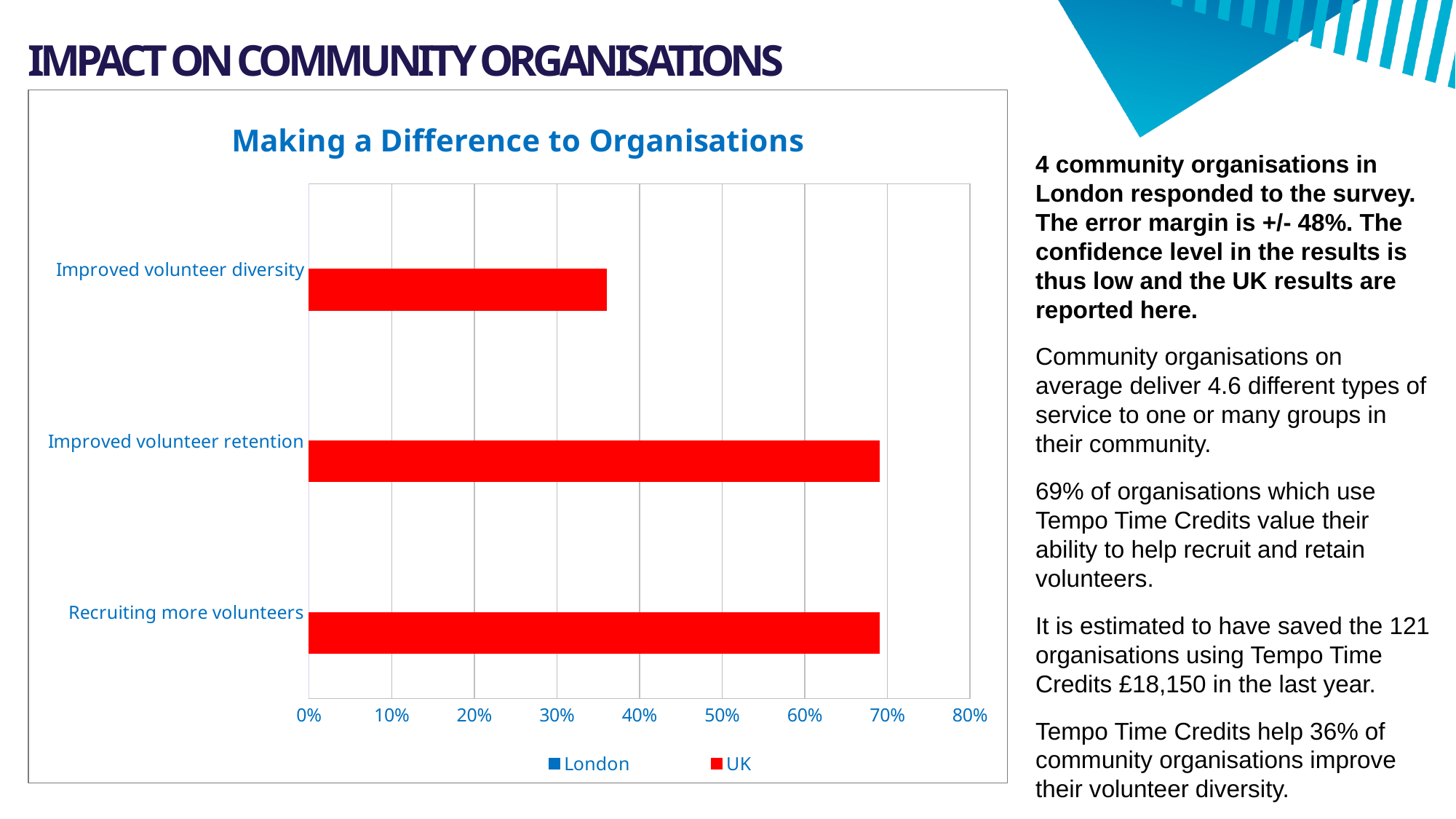
Which category has the lowest UK value? Improved volunteer diversity Which has a larger UK value: Improved volunteer retention or Improved volunteer diversity? Improved volunteer retention Is the UK value for Improved volunteer diversity greater or less than 30%? greater Is the UK value for Recruiting more volunteers greater or less than 60%? greater Is the UK value for Improved volunteer diversity greater or less than 40%? less What kind of chart is shown on the slide? bar chart How many series does the chart legend list? 2 What is the title of the chart? Making a Difference to Organisations What colour are the UK bars in the chart? red How many categories are shown on the chart's vertical axis? 3